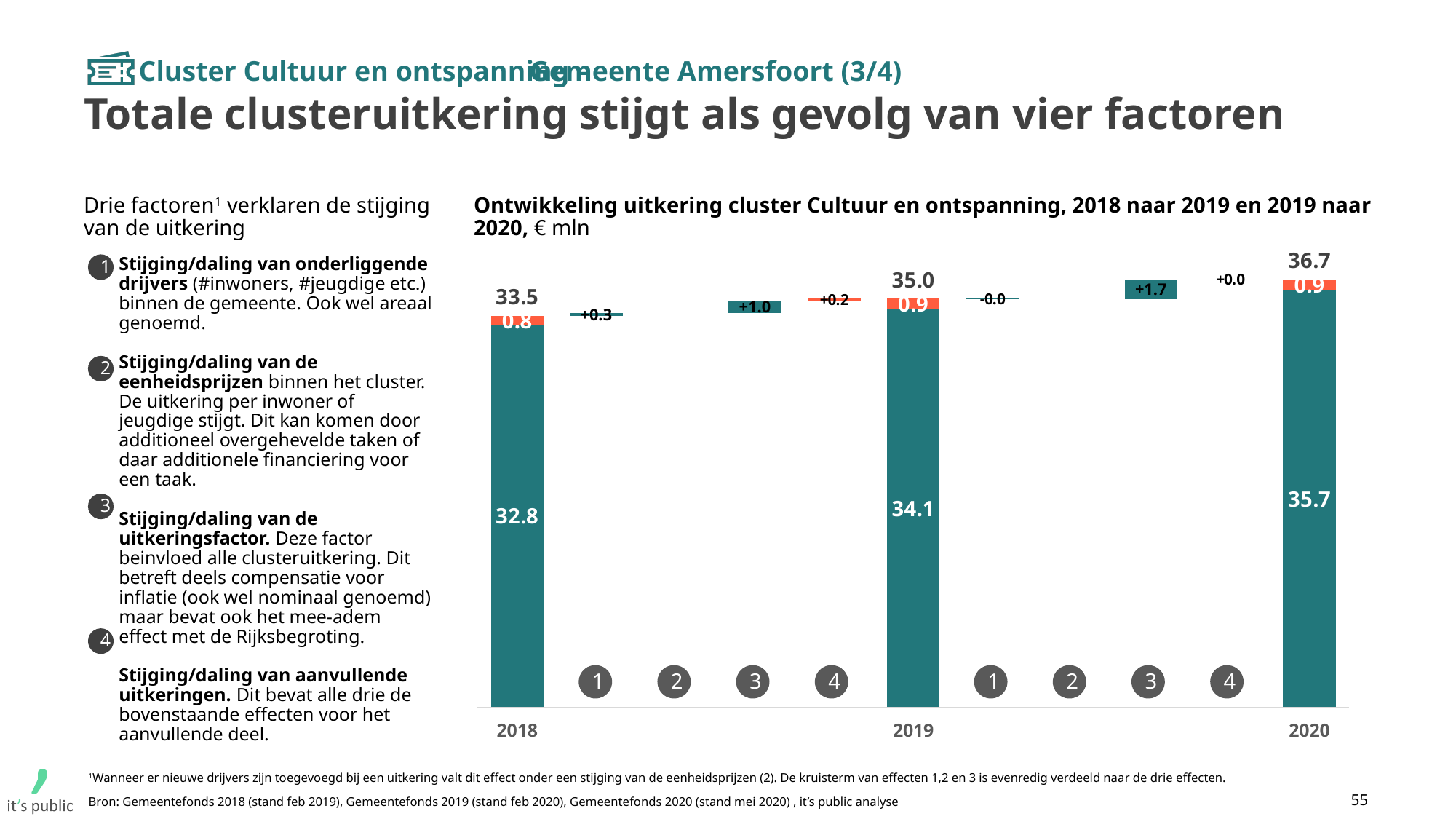
In what unit are the values on the chart expressed? € mln What is the value of the large teal segment of the 2019 bar? 34.1 What is the value of the large teal segment of the 2020 bar? 35.7 What is the effect of factor 3 (uitkeringsfactor) from 2019 to 2020? +1.7 What is the total uitkering for 2018 shown on the chart? 33.5 Do the total uitkering values rise or fall from 2018 to 2020? rise What is the total uitkering for 2020 shown on the chart? 36.7 Which year has the highest total uitkering? 2020 By how much did the total uitkering increase from 2018 to 2020? 3.2 What is the total uitkering for 2019 shown on the chart? 35.0 What is the effect of factor 1 from 2018 to 2019? +0.3